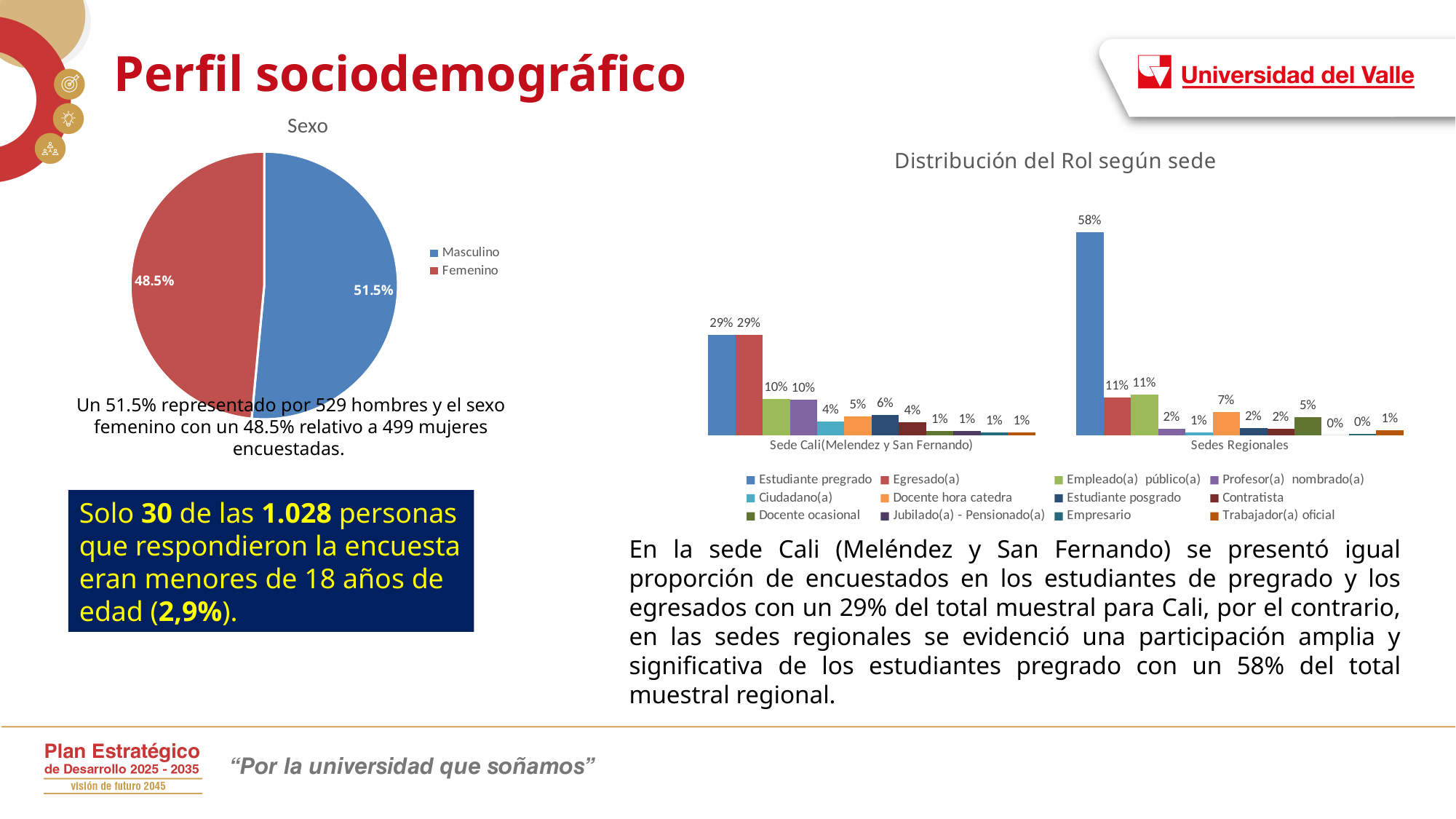
In the 'Distribución del Rol según sede' chart, how many sede categories are shown on the x axis? 2 In the 'Sexo' pie chart, what share is shown for Femenino? 48.5% In the 'Distribución del Rol según sede' chart, what is the value for Egresado(a) in Sede Cali(Melendez y San Fernando)? 29% In the 'Distribución del Rol según sede' chart, which role has the highest value in Sedes Regionales? Estudiante pregrado In the 'Distribución del Rol según sede' chart, how many series does the legend list? 12 What kind of chart is 'Distribución del Rol según sede'? Bar chart In the 'Sexo' pie chart, what share is shown for Masculino? 51.5% In the 'Distribución del Rol según sede' chart, what is the value for Docente hora catedra in Sedes Regionales? 7% In the 'Sexo' pie chart, which slice is larger, Masculino or Femenino? Masculino What kind of chart is the 'Sexo' chart? Pie chart In the 'Distribución del Rol según sede' chart, what is the value for Estudiante pregrado in Sedes Regionales? 58% In the 'Distribución del Rol según sede' chart, what is the difference between Estudiante pregrado in Sedes Regionales and Estudiante pregrado in Sede Cali(Melendez y San Fernando)? 29%